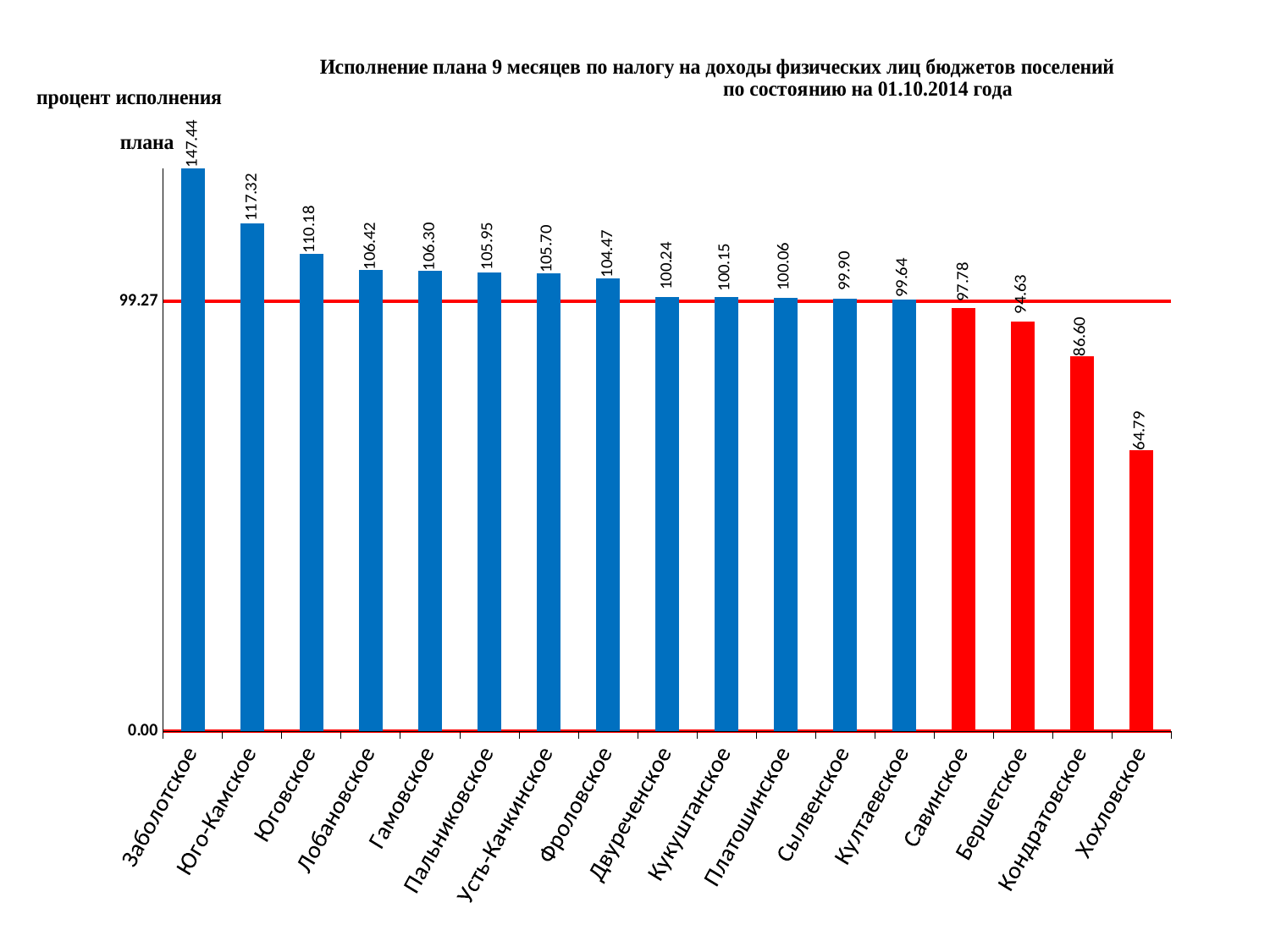
Which category has the lowest value? Хохловское What is the value for Кондратовское? 86.60 What value is marked by the horizontal red line on the y axis? 99.27 Which category has the highest value? Заболотское Which is larger, the value for Юговское or the value for Бершетское? Юговское What is the value for Заболотское? 147.44 How many bars are coloured red? 4 How many categories are shown on the x axis? 17 What is the value for Хохловское? 64.79 What is the difference between the values for Заболотское and Юго-Камское? 30.12 What kind of chart is this? bar chart Do the values rise or fall from left to right along the x axis? fall